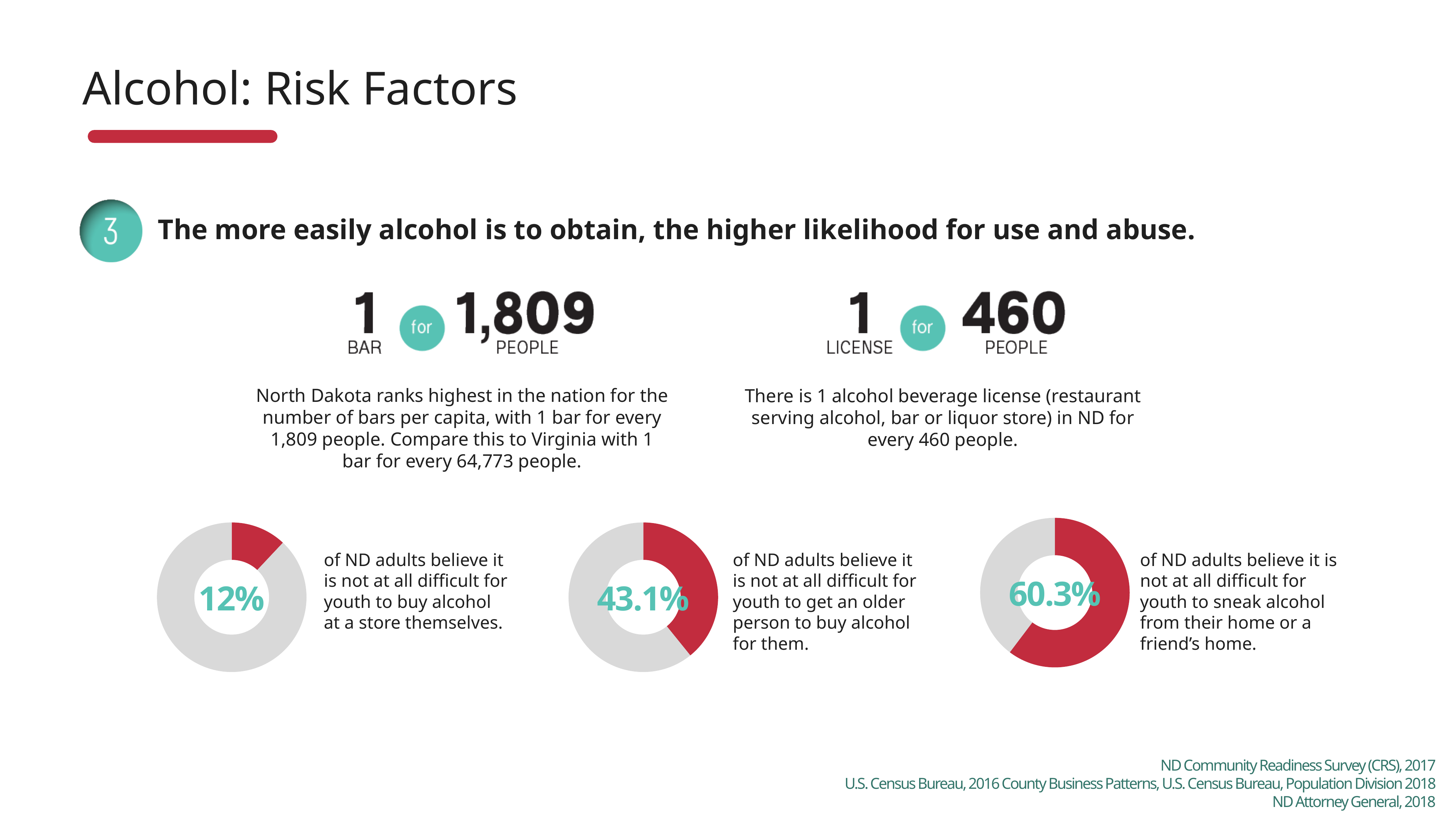
What colour is used for the filled (highlighted) portion of each donut chart? Red Is the value shown in the right donut chart greater or less than 50%? greater In the right donut chart, what percentage of ND adults believe it is not at all difficult for youth to sneak alcohol from their home or a friend's home? 60.3% How many donut charts are shown on the slide? 3 In the left donut chart, what percentage of ND adults believe it is not at all difficult for youth to buy alcohol at a store themselves? 12% What is the difference between the percentage in the middle donut chart (43.1%) and the percentage in the left donut chart (12%)? 31.1 percentage points Which of the three donut charts shows the highest percentage? The right chart (sneak alcohol from home), 60.3% What is the difference between the percentage in the right donut chart (60.3%) and the percentage in the middle donut chart (43.1%)? 17.2 percentage points Which of the three donut charts shows the lowest percentage? The left chart (buy alcohol at a store), 12% What kind of chart is used to show the percentage of ND adults who believe it is not at all difficult for youth to buy alcohol at a store themselves? Donut chart Is the percentage in the middle donut chart (getting an older person to buy alcohol) larger or smaller than the percentage in the left donut chart (buying at a store)? Larger In the middle donut chart, what percentage of ND adults believe it is not at all difficult for youth to get an older person to buy alcohol for them? 43.1%